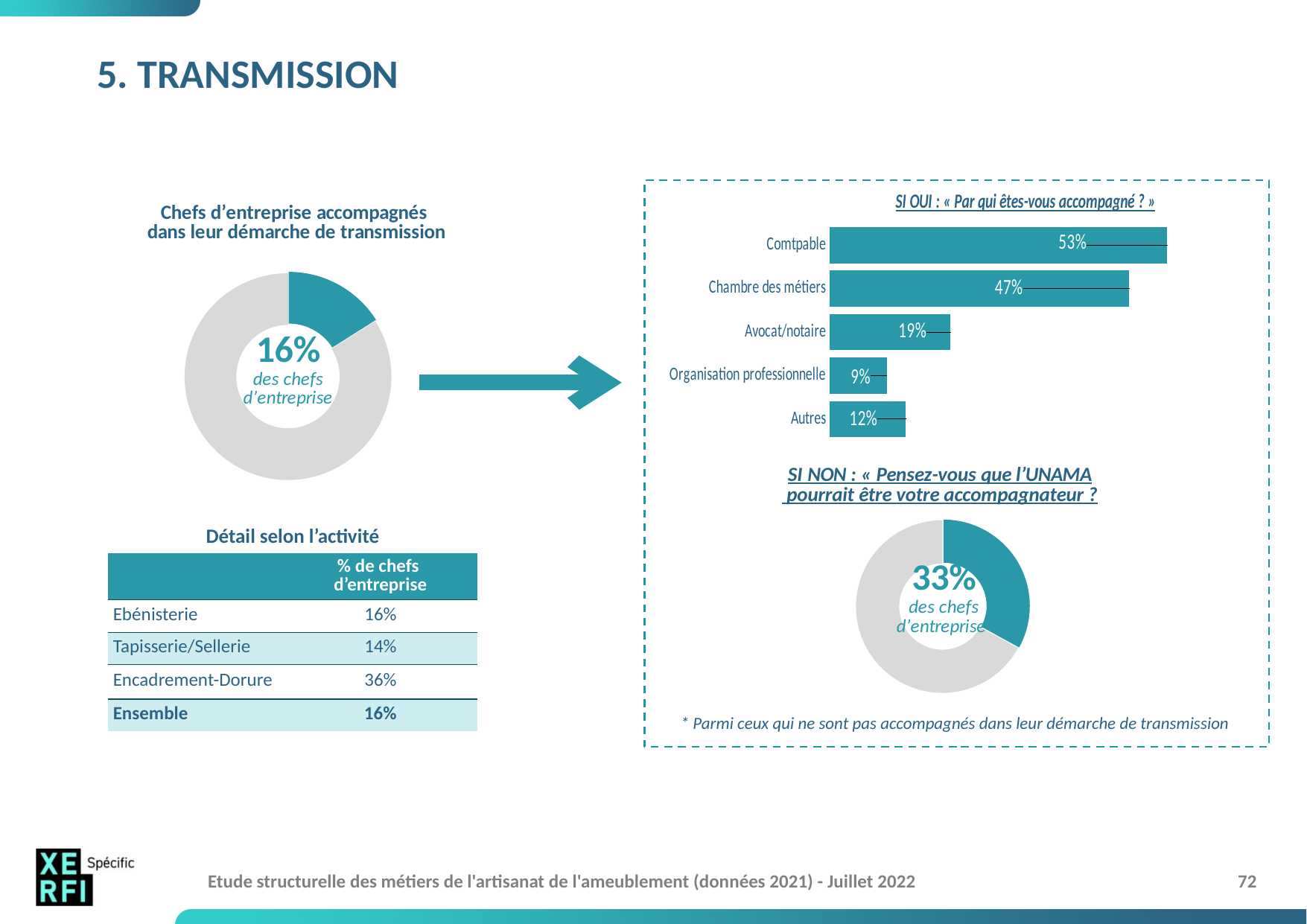
In the donut chart 'Chefs d'entreprise accompagnés dans leur démarche de transmission', what share of chefs d'entreprise is highlighted? 16% In the bar chart 'SI OUI : « Par qui êtes-vous accompagné ? »', what is the difference between Comtpable and Avocat/notaire? 34% In the donut chart under 'SI NON : « Pensez-vous que l'UNAMA pourrait être votre accompagnateur ? »', what share of chefs d'entreprise is highlighted? 33% What kind of chart is used for 'Chefs d'entreprise accompagnés dans leur démarche de transmission'? Donut chart In the bar chart 'SI OUI : « Par qui êtes-vous accompagné ? »', what is the value for Chambre des métiers? 47% In the bar chart 'SI OUI : « Par qui êtes-vous accompagné ? »', what is the value for Organisation professionnelle? 9% In the bar chart 'SI OUI : « Par qui êtes-vous accompagné ? »', which category has the lowest value? Organisation professionnelle In the bar chart 'SI OUI : « Par qui êtes-vous accompagné ? »', what is the value for Comtpable? 53% What kind of chart is 'SI OUI : « Par qui êtes-vous accompagné ? »'? Bar chart How many categories are shown in the bar chart 'SI OUI : « Par qui êtes-vous accompagné ? »'? 5 In the bar chart 'SI OUI : « Par qui êtes-vous accompagné ? »', which category has the highest value? Comtpable In the bar chart 'SI OUI : « Par qui êtes-vous accompagné ? »', which is larger: Autres or Organisation professionnelle? Autres